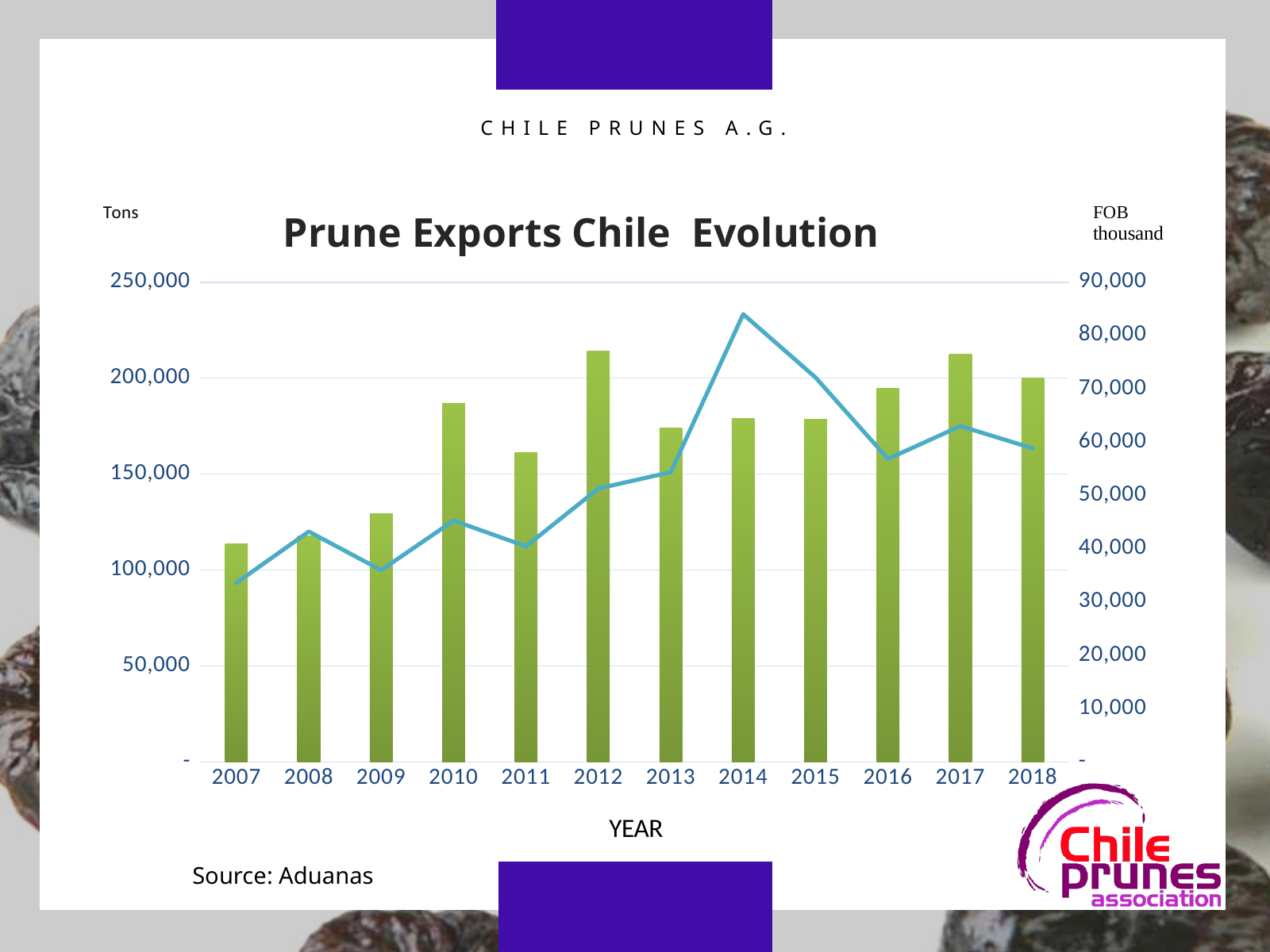
Is the FOB value for 2014 greater or less than 80,000? greater In which year does the FOB line reach its highest point? 2014 What kind of chart is shown on the slide? A combined bar and line chart Is the tons value for 2009 greater or less than 150,000? less Which year has the lowest bar (tons) in the chart? 2007 Does the FOB line rise or fall from 2014 to 2016? fall How many years are shown on the x axis of the chart? 12 Is the tons value for 2012 greater or less than 200,000? greater In which year is the FOB line at its lowest point? 2007 Which year has the taller bar, 2010 or 2011? 2010 What is the title of the chart? Prune Exports Chile Evolution What is the source cited for the chart data? Aduanas